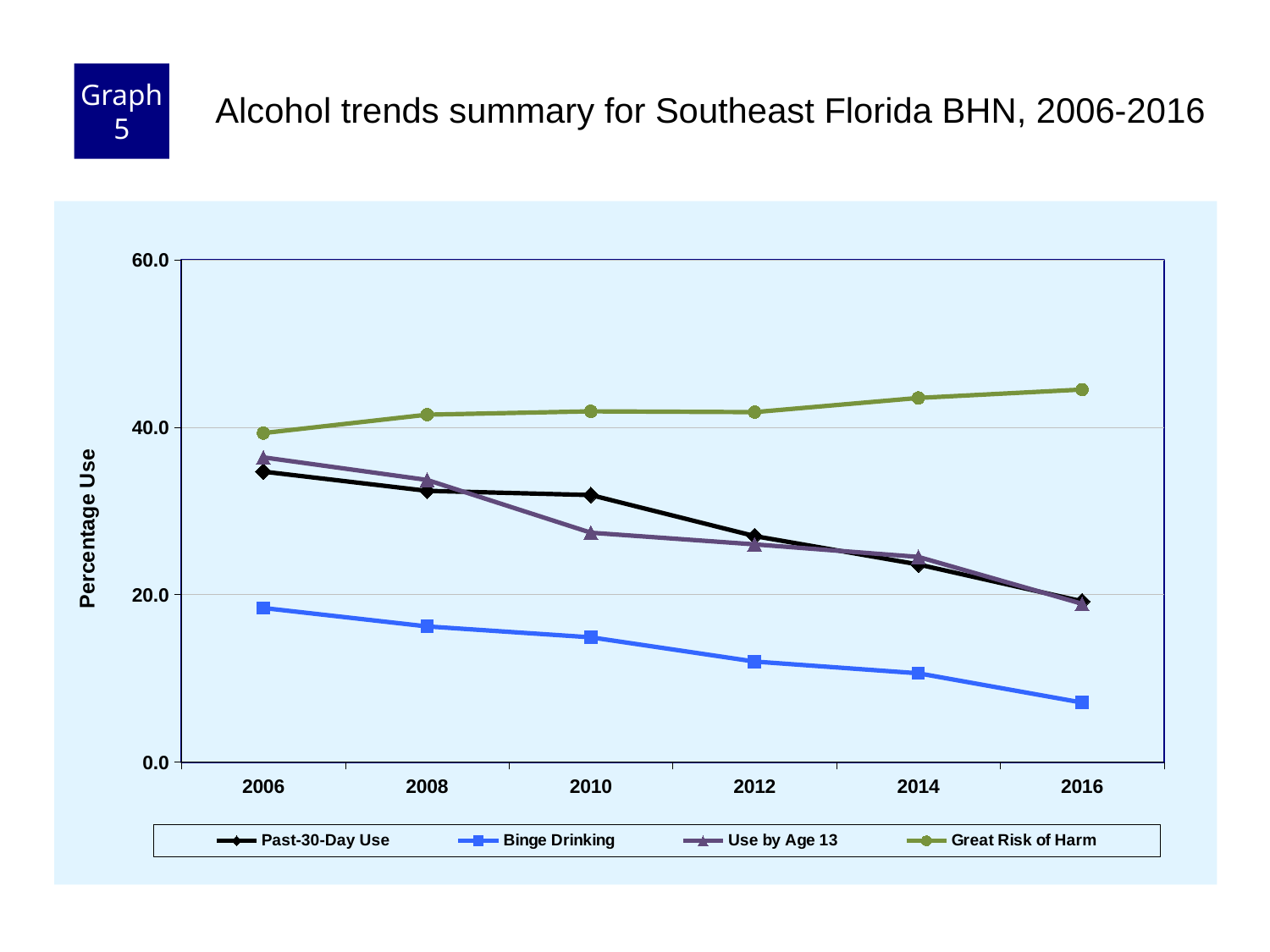
What kind of chart is shown on the slide? line chart What is the label on the y axis? Percentage Use In 2010, which is larger: Past-30-Day Use or Use by Age 13? Past-30-Day Use Does the Binge Drinking line rise or fall from 2006 to 2016? fall Does the Great Risk of Harm line rise or fall from 2006 to 2016? rise Is the value for Great Risk of Harm in 2016 greater or less than 40.0? greater How many years are plotted along the x axis? 6 How many series does the legend list? 4 Is the value for Use by Age 13 in 2010 greater or less than 20.0? greater Which series has the highest value in 2016? Great Risk of Harm Is the value for Binge Drinking in 2016 greater or less than 20.0? less Which series has the lowest value in 2006? Binge Drinking